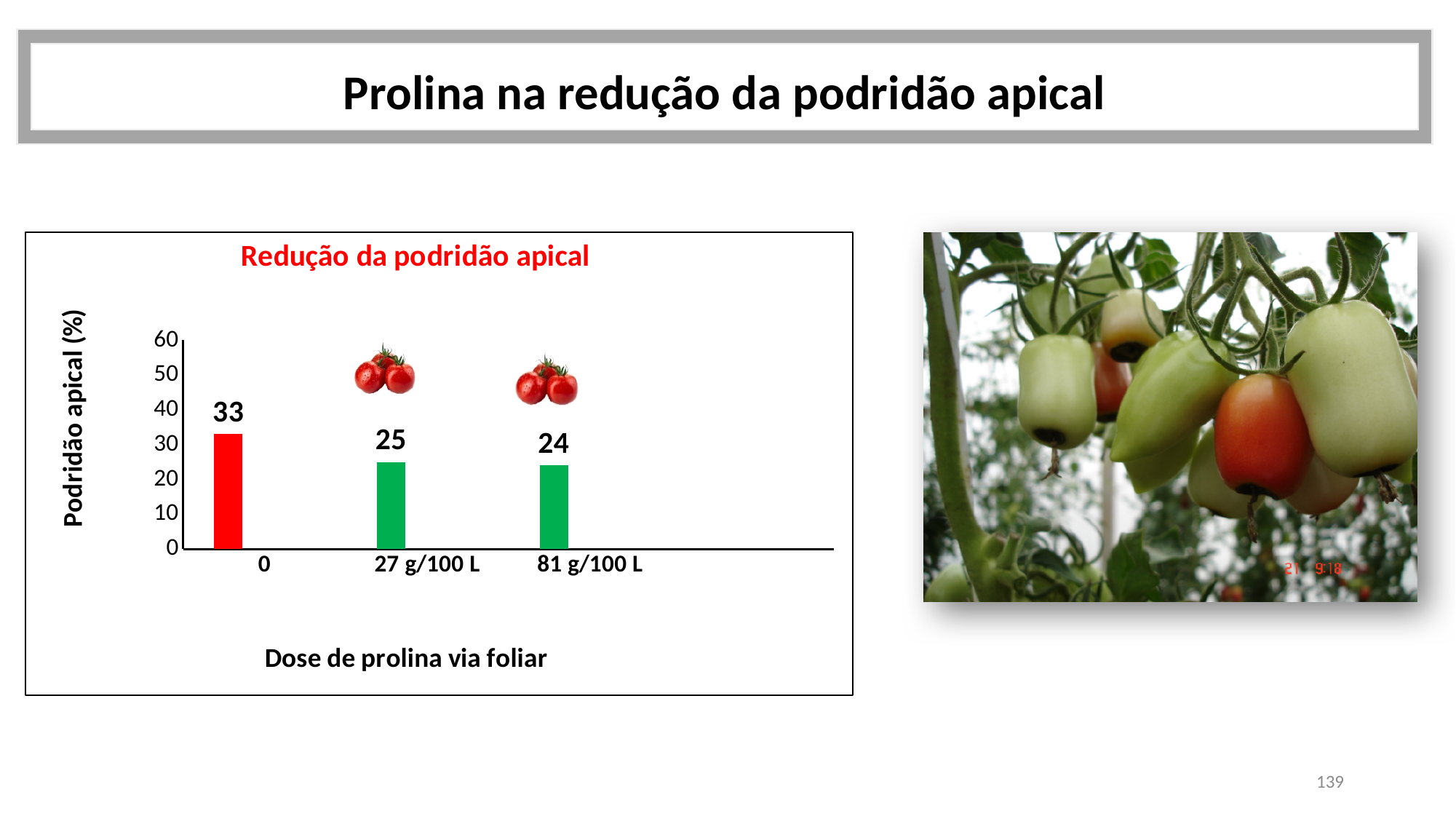
What is the difference in Podridão apical (%) between dose 0 and dose 27 g/100 L? 8 What is the value of Podridão apical (%) for the dose 0? 33 What is the value of Podridão apical (%) for the dose 27 g/100 L? 25 Is the value for dose 0 greater or less than 30? greater Which has a larger Podridão apical (%): dose 0 or dose 81 g/100 L? 0 What is the title of the chart? Redução da podridão apical What is the difference in Podridão apical (%) between dose 0 and dose 81 g/100 L? 9 What kind of chart is shown on the slide? bar chart Which dose has the lowest Podridão apical (%)? 81 g/100 L Which dose has the highest Podridão apical (%)? 0 What is the value of Podridão apical (%) for the dose 81 g/100 L? 24 How many doses (bars) are shown in the chart? 3